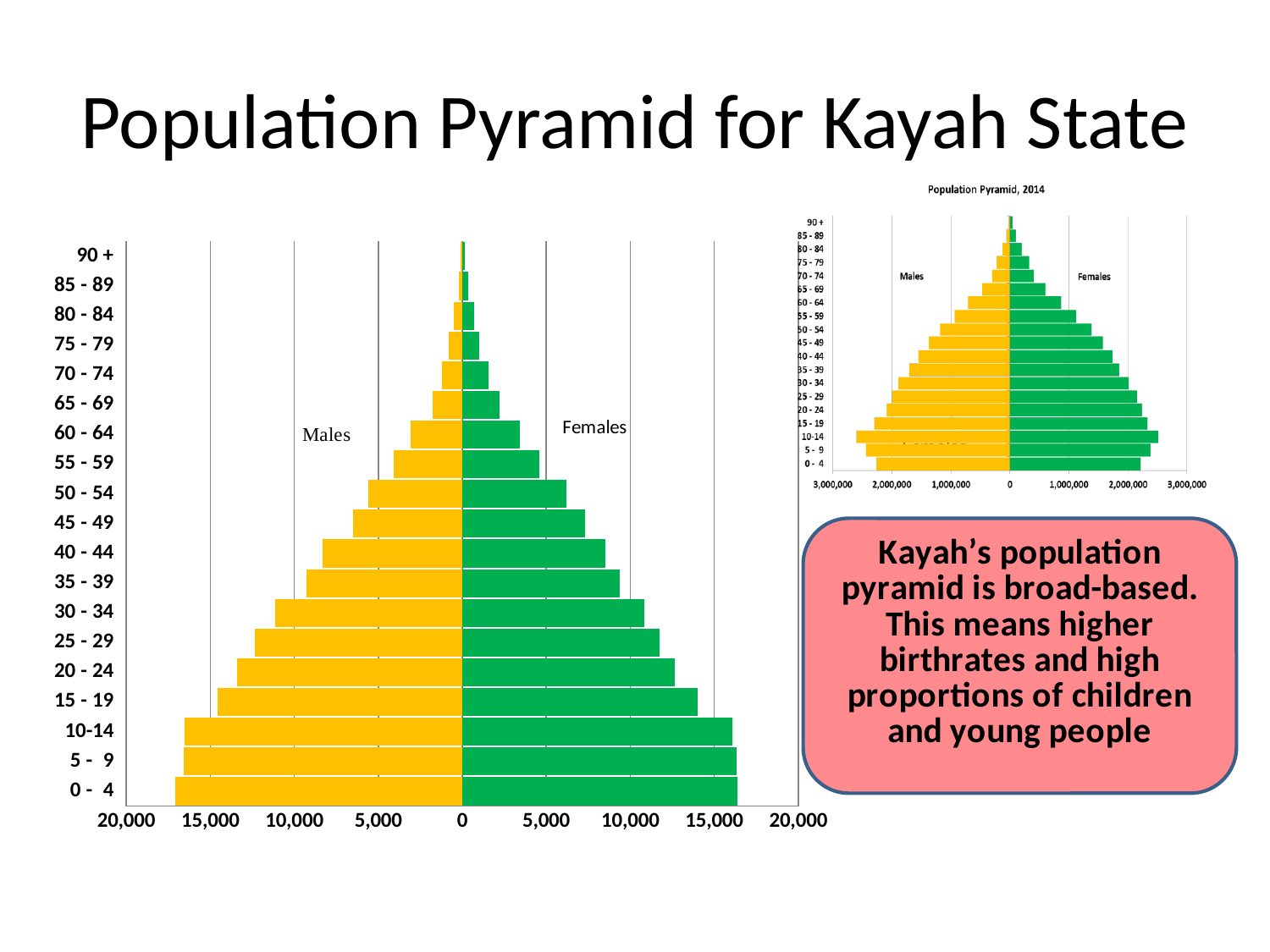
In the large chart on the left, do the bar lengths generally increase or decrease as the age groups get older? decrease In the large chart on the left, is the value for Females aged 40 - 44 greater or less than 10,000? less In the large chart on the left, is the value for Males aged 60 - 64 greater or less than 5,000? less In the large chart on the left, which is larger: the Males bar for 0 - 4 or the Males bar for 60 - 64? 0 - 4 What is the title of the small chart at the top right of the slide? Population Pyramid, 2014 What kind of chart is the large chart on the left of the slide? Bar chart (population pyramid) In the large chart on the left, is the value for Males aged 0 - 4 greater or less than 15,000? greater In the large chart on the left, which two groups are plotted? Males and Females In the large chart on the left, which age group has the smallest bars for both Males and Females? 90 + In the large chart on the left, how many age groups are shown on the vertical axis? 19